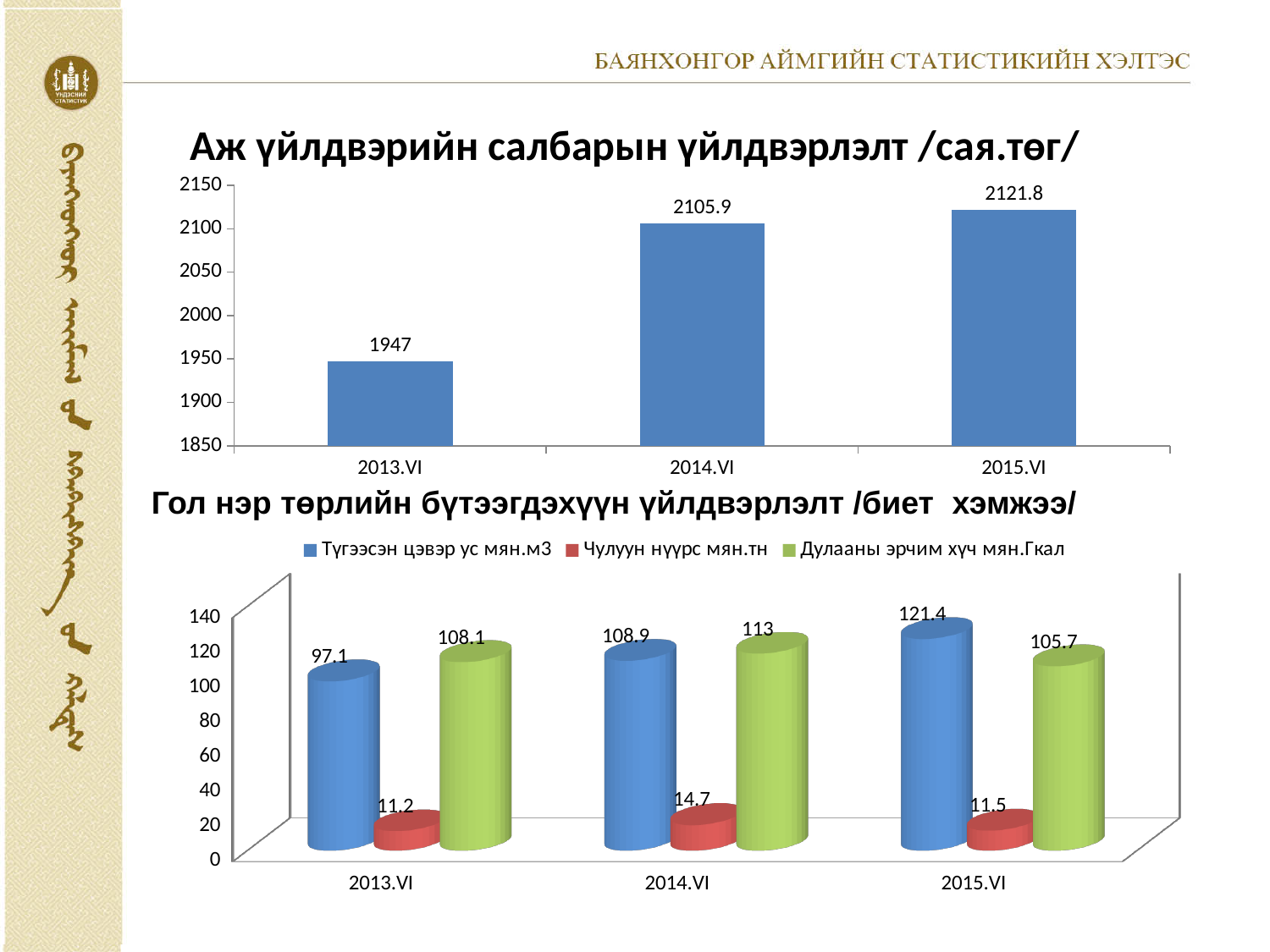
In the top chart (Аж үйлдвэрийн салбарын үйлдвэрлэлт), what is the difference between the 2015.VI and 2013.VI values? 174.8 What kind of chart is the top chart (Аж үйлдвэрийн салбарын үйлдвэрлэлт)? bar chart In the bottom chart (Гол нэр төрлийн бүтээгдэхүүн үйлдвэрлэлт), how many series does the legend list? 3 In the bottom chart (Гол нэр төрлийн бүтээгдэхүүн үйлдвэрлэлт), what colour are the bars for Чулуун нүүрс мян.тн? red In the bottom chart (Гол нэр төрлийн бүтээгдэхүүн үйлдвэрлэлт), which is larger for 2013.VI: Түгээсэн цэвэр ус мян.м3 or Дулааны эрчим хүч мян.Гкал? Дулааны эрчим хүч мян.Гкал In the top chart (Аж үйлдвэрийн салбарын үйлдвэрлэлт), do the values rise or fall from 2013.VI to 2015.VI? rise In the bottom chart (Гол нэр төрлийн бүтээгдэхүүн үйлдвэрлэлт), which period has the highest value for Дулааны эрчим хүч мян.Гкал? 2014.VI In the top chart (Аж үйлдвэрийн салбарын үйлдвэрлэлт), how many periods are shown on the x axis? 3 In the bottom chart (Гол нэр төрлийн бүтээгдэхүүн үйлдвэрлэлт), what is the value of Чулуун нүүрс мян.тн for 2014.VI? 14.7 In the top chart (Аж үйлдвэрийн салбарын үйлдвэрлэлт), what is the value for 2014.VI? 2105.9 In the bottom chart (Гол нэр төрлийн бүтээгдэхүүн үйлдвэрлэлт), what is the value of Түгээсэн цэвэр ус мян.м3 for 2015.VI? 121.4 In the top chart (Аж үйлдвэрийн салбарын үйлдвэрлэлт), which period has the lowest value? 2013.VI